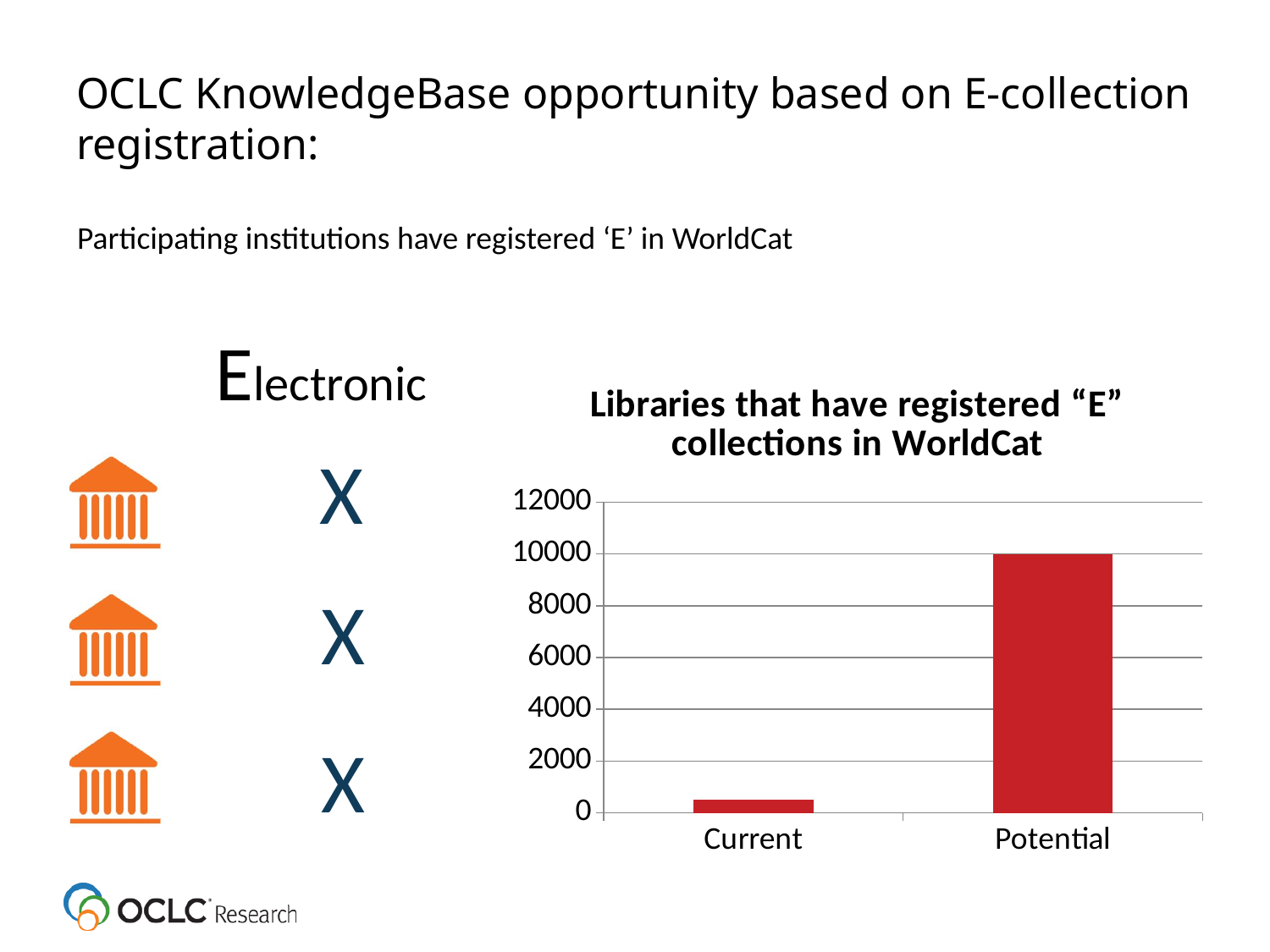
What is the title of the chart? Libraries that have registered "E" collections in WorldCat Do the values rise or fall from Current to Potential along the x axis? rise What kind of chart is shown on the slide? bar chart Which category has the lowest value in the chart? Current Is the value for Current greater or less than 2000? less Is the value for Potential greater or less than 12000? less Which category has the highest value in the chart? Potential How many categories are plotted on the x axis of the chart? 2 Which is larger, the value for Current or the value for Potential? Potential What colour are the bars in the chart? red What value does the Potential bar reach on the y axis? 10000 Is the value for Potential greater or less than 8000? greater